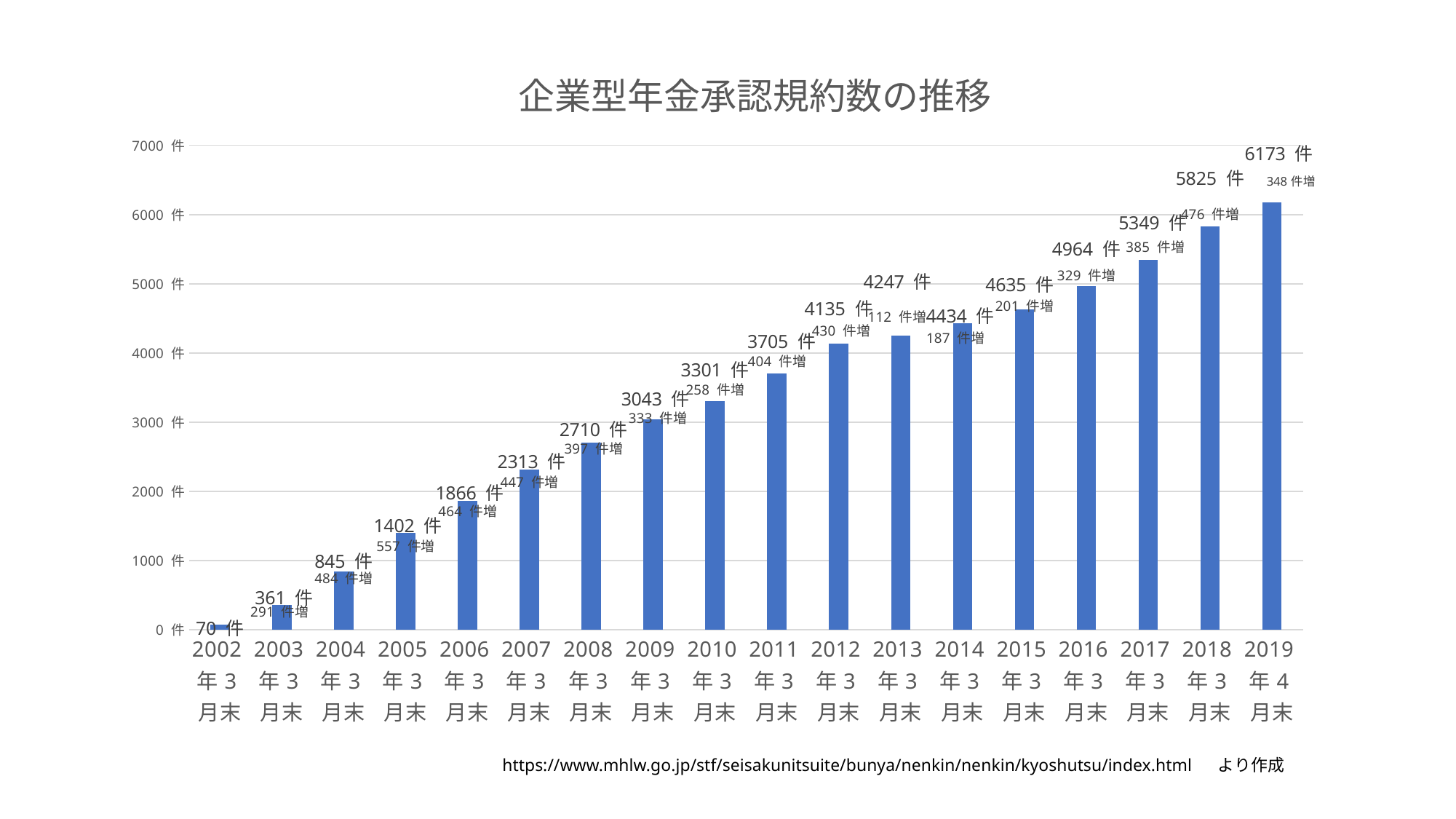
Which is larger, the value for 2008年3月末 or the value for 2009年3月末? 2009年3月末 Which period has the lowest value? 2002年3月末 What is the value for 2010年3月末? 3301 件 What is the value for 2019年4月末? 6173 件 Which period has the highest value? 2019年4月末 How many bars are shown in the chart? 18 Do the values rise or fall from 2002年3月末 to 2019年4月末? rise What kind of chart is shown on the slide? bar chart What is the difference between the values for 2018年3月末 and 2017年3月末? 476 件 What is the value for 2005年3月末? 1402 件 Is the value for 2016年3月末 greater or less than 5000 件? less What is the difference between the values for 2014年3月末 and 2012年3月末? 299 件